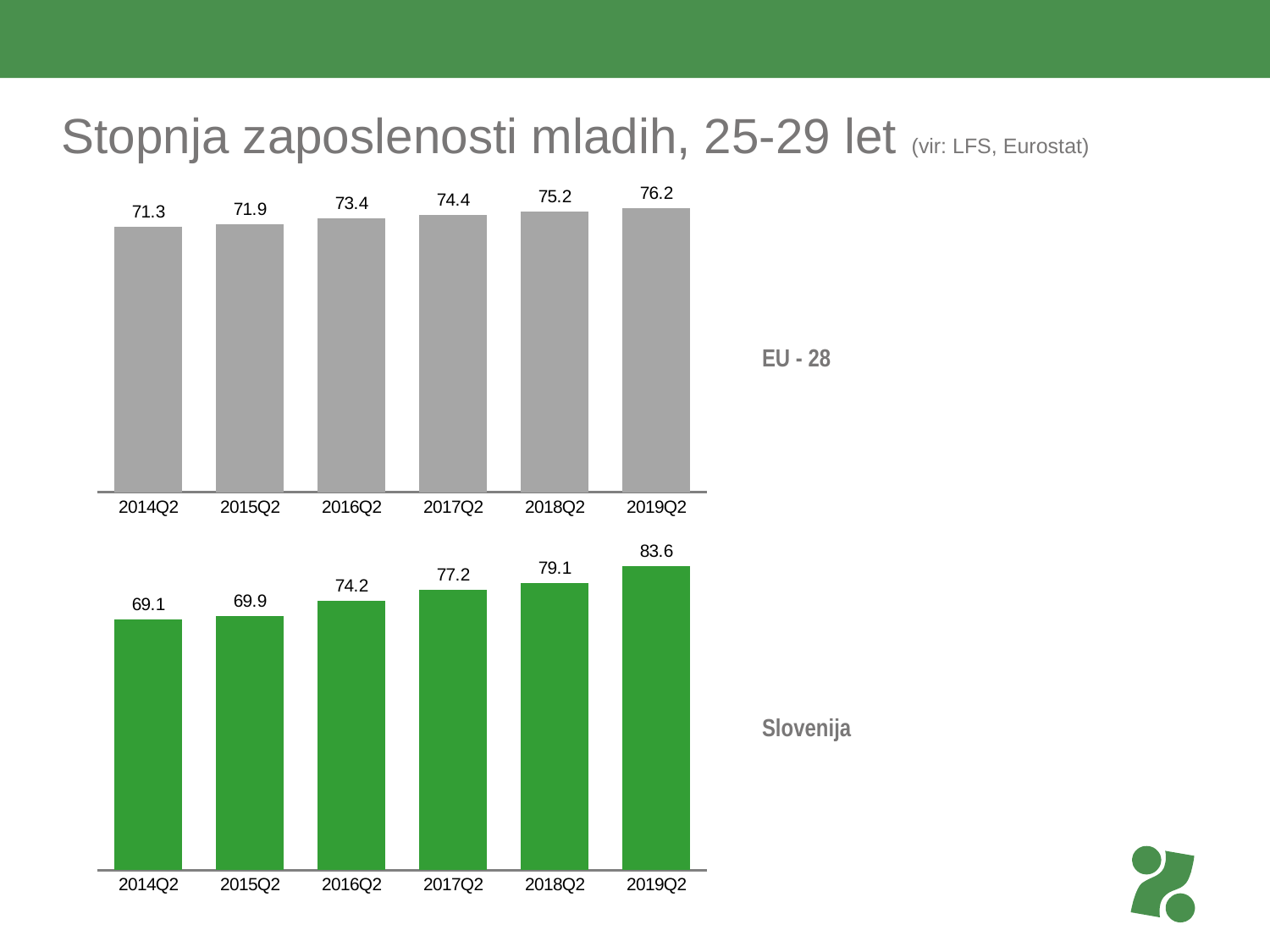
In the EU - 28 chart, what is the difference between the 2018Q2 and 2017Q2 values? 0.8 In the Slovenija chart, which quarter has the lowest value? 2014Q2 How many quarters are shown in the EU - 28 chart? 6 What colour are the bars in the EU - 28 chart? grey What kind of chart is the Slovenija chart? bar chart In the Slovenija chart, what is the value for 2017Q2? 77.2 In the EU - 28 chart, what is the value for 2014Q2? 71.3 In the Slovenija chart, what is the value for 2019Q2? 83.6 In the Slovenija chart, do the values rise or fall from 2014Q2 to 2019Q2? rise Which is larger: the 2019Q2 value in the Slovenija chart or the 2019Q2 value in the EU - 28 chart? Slovenija In the Slovenija chart, what is the difference between the 2019Q2 and 2014Q2 values? 14.5 In the EU - 28 chart, which quarter has the highest value? 2019Q2